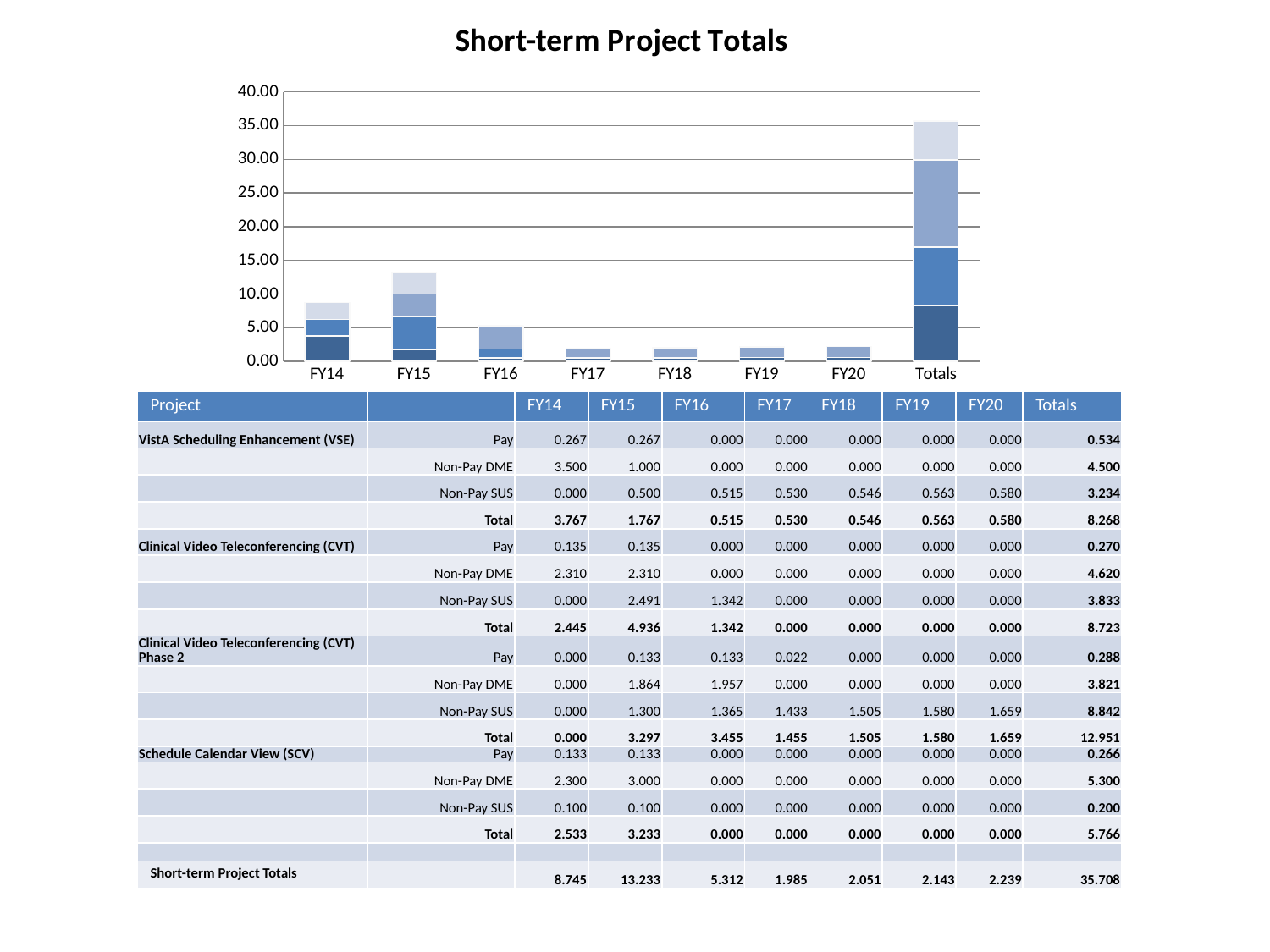
Which bar is taller, FY14 or FY15? FY15 Which bar in the chart is the tallest? Totals Is the stacked bar for FY17 greater or less than 5.00? less How many bars are plotted along the x axis of the chart? 8 Is the stacked bar for FY15 greater or less than 15.00? less Is the stacked bar for FY15 greater or less than 10.00? greater Among the fiscal-year bars FY14 to FY20, which is the tallest? FY15 Do the stacked bar heights rise or fall from FY15 to FY17? fall What is the title of the chart? Short-term Project Totals What type of chart is shown on the slide? Stacked bar chart